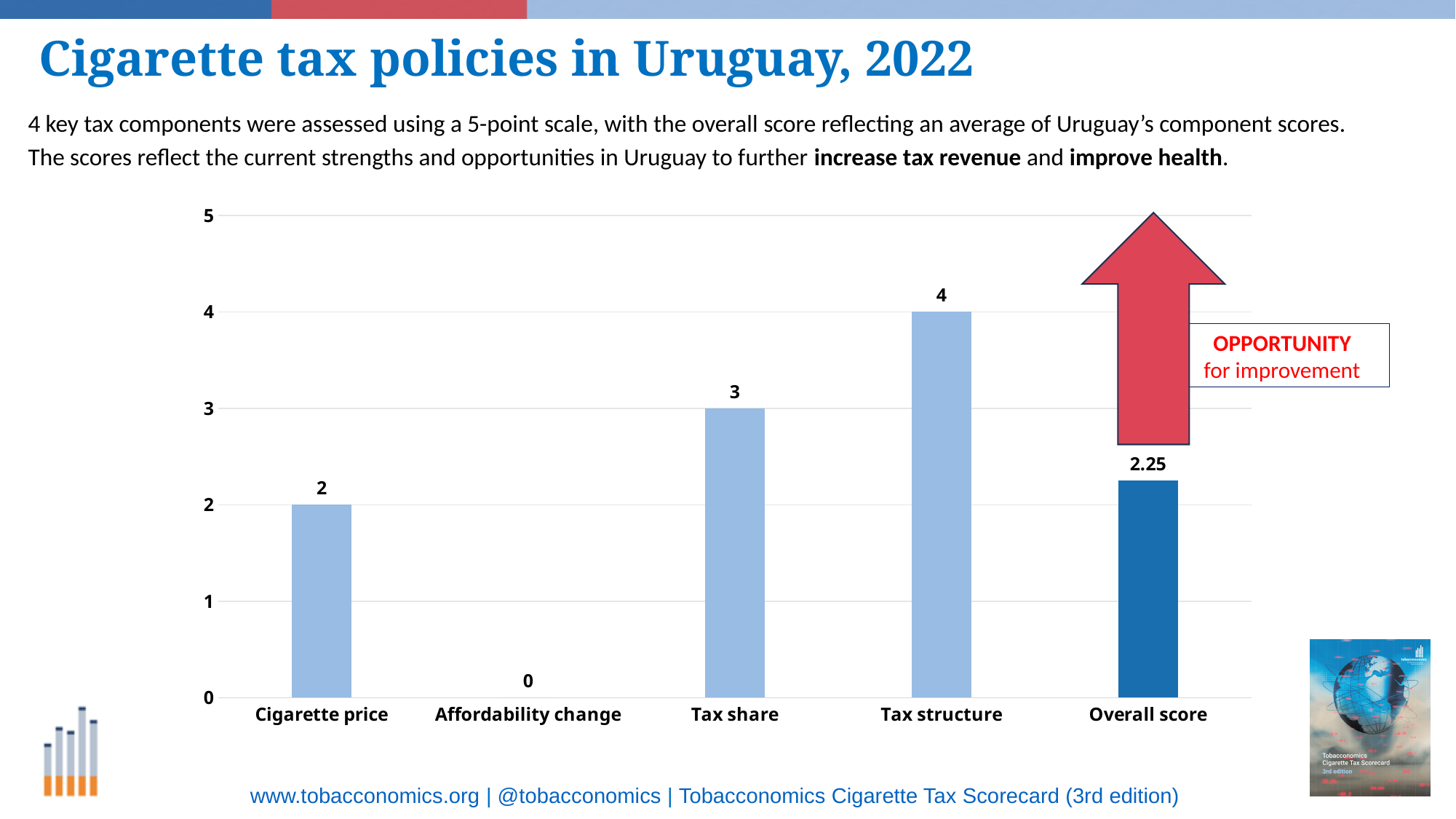
What is the score for Cigarette price? 2 Which is larger, the score for Tax share or the score for Cigarette price? Tax share Is the Overall score greater or less than 3? less Which category has the highest score on the chart? Tax structure Which category has the lowest score on the chart? Affordability change What is the difference between the Tax structure score and the Tax share score? 1 What is the score for Affordability change? 0 What is the Overall score shown on the chart? 2.25 What is the score for Tax structure? 4 What is the maximum value shown on the chart's y axis? 5 How many categories are shown on the x axis of the chart? 5 What kind of chart is shown on the slide? bar chart